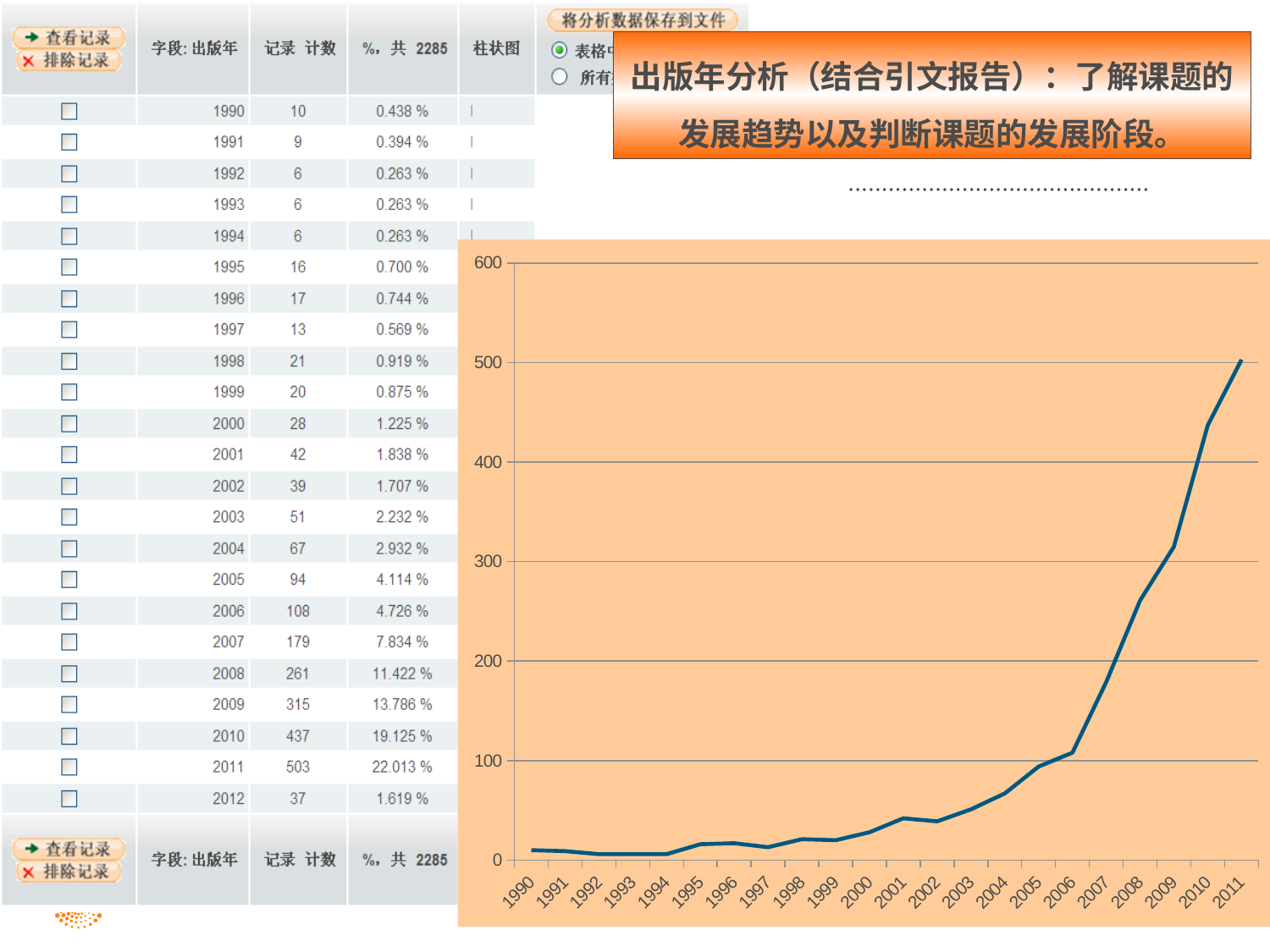
Do the values in the line chart generally rise or fall from 1990 to 2011? rise Using the counts printed in the table, what is the difference between the values for 2011 and 2010? 66 In the line chart, is the value for 2004 greater or less than 100? less In the line chart, is the value for 2008 greater or less than 200? greater What kind of chart is shown on the slide? line chart How many years are plotted along the x axis of the line chart? 22 According to the table on the slide, what is the record count for 2008? 261 In the line chart, which year has the larger value, 2009 or 2010? 2010 In the line chart, is the value for 2010 greater or less than 400? greater According to the table on the slide, what is the record count for 2011? 503 Which year has the highest value in the line chart? 2011